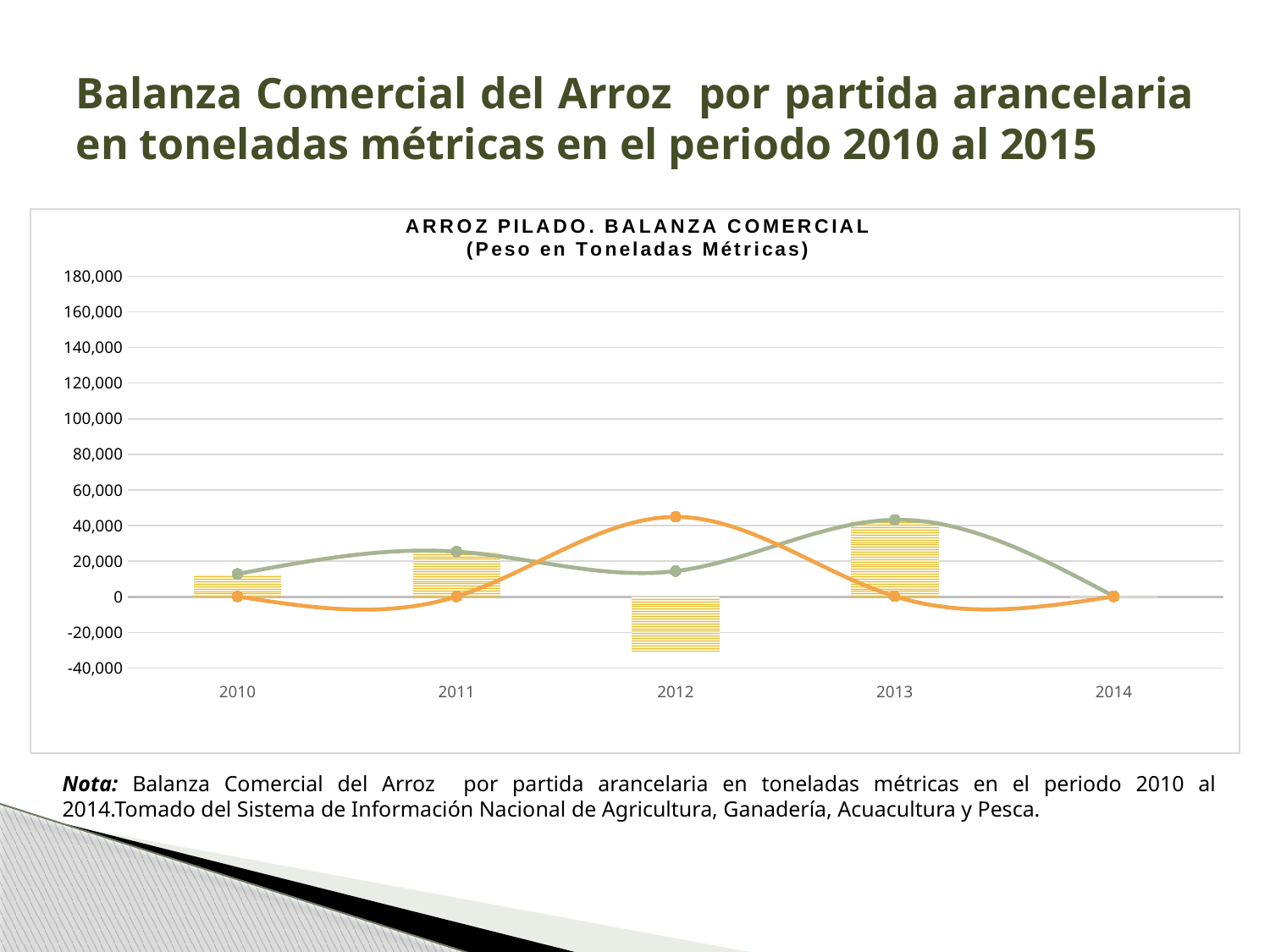
Which year has the tallest bar in the chart? 2013 In which year does the green line reach its highest point? 2013 What is the highest value shown on the vertical axis? 180,000 Is the bar value for 2013 greater or less than 20,000? greater What is the title of the chart? ARROZ PILADO. BALANZA COMERCIAL (Peso en Toneladas Métricas) What kind of chart is shown on the slide? Combined bar and line chart Is the bar value for 2010 greater or less than 20,000? less Is the bar value for 2012 greater or less than 0? less In which year does the orange line reach its highest point? 2012 Which year has the lowest bar in the chart? 2012 Which bar is larger, 2011 or 2013? 2013 How many years are shown on the x axis of the chart? 5